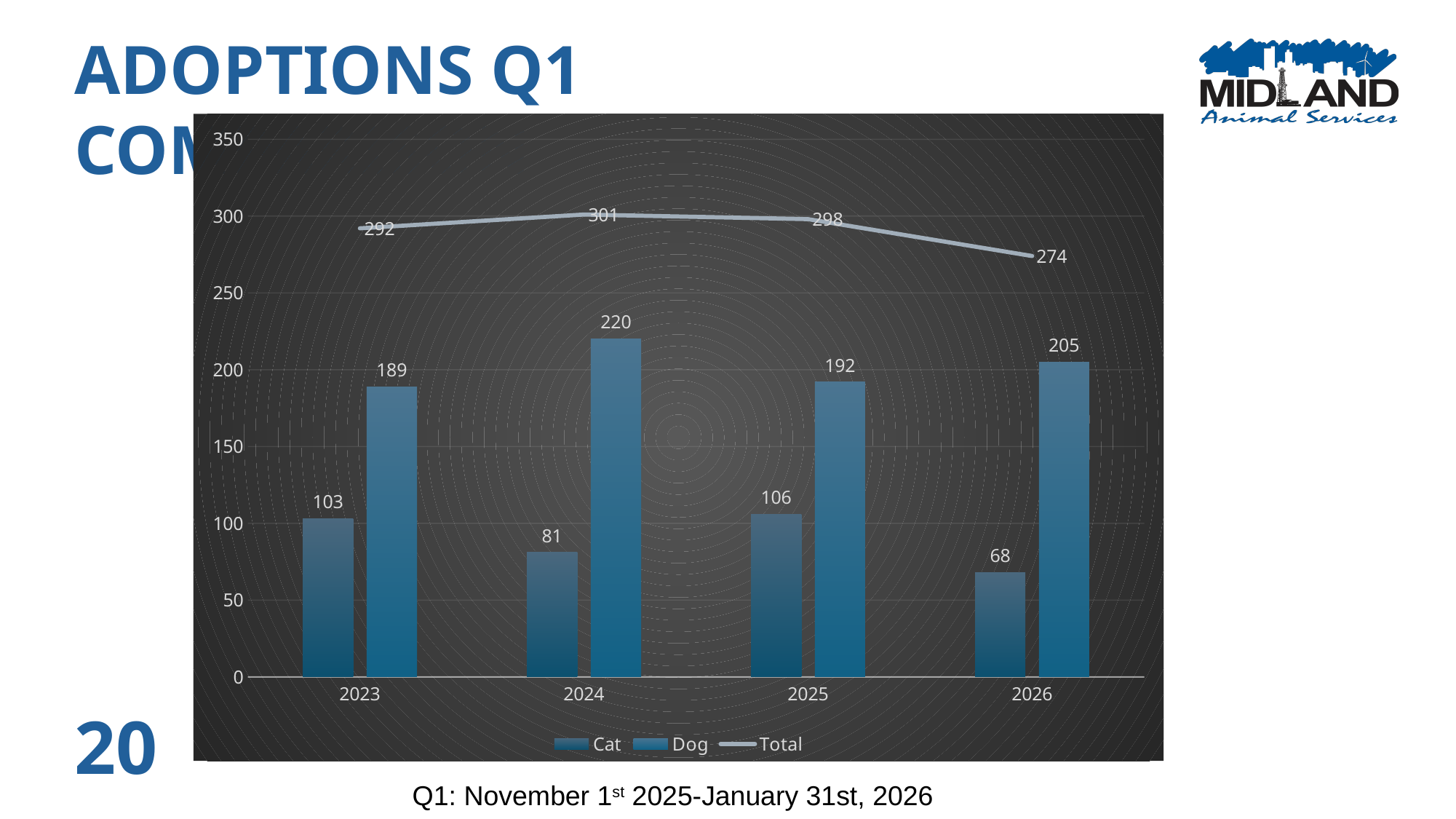
Does the Total line rise or fall from 2025 to 2026? fall How many years are shown on the x axis? 4 What is the value for Cat in 2023? 103 In which year is the Dog value highest? 2024 How many series does the legend list? 3 What is the difference between the Dog and Cat values in 2025? 86 In which year is the Cat value lowest? 2026 Which is larger, the Cat value in 2023 or the Cat value in 2025? Cat value in 2025 Which series is drawn as a line rather than bars? Total What is the Total value for 2026? 274 Is the Dog value for 2026 greater or less than 150? greater What is the value for Dog in 2024? 220